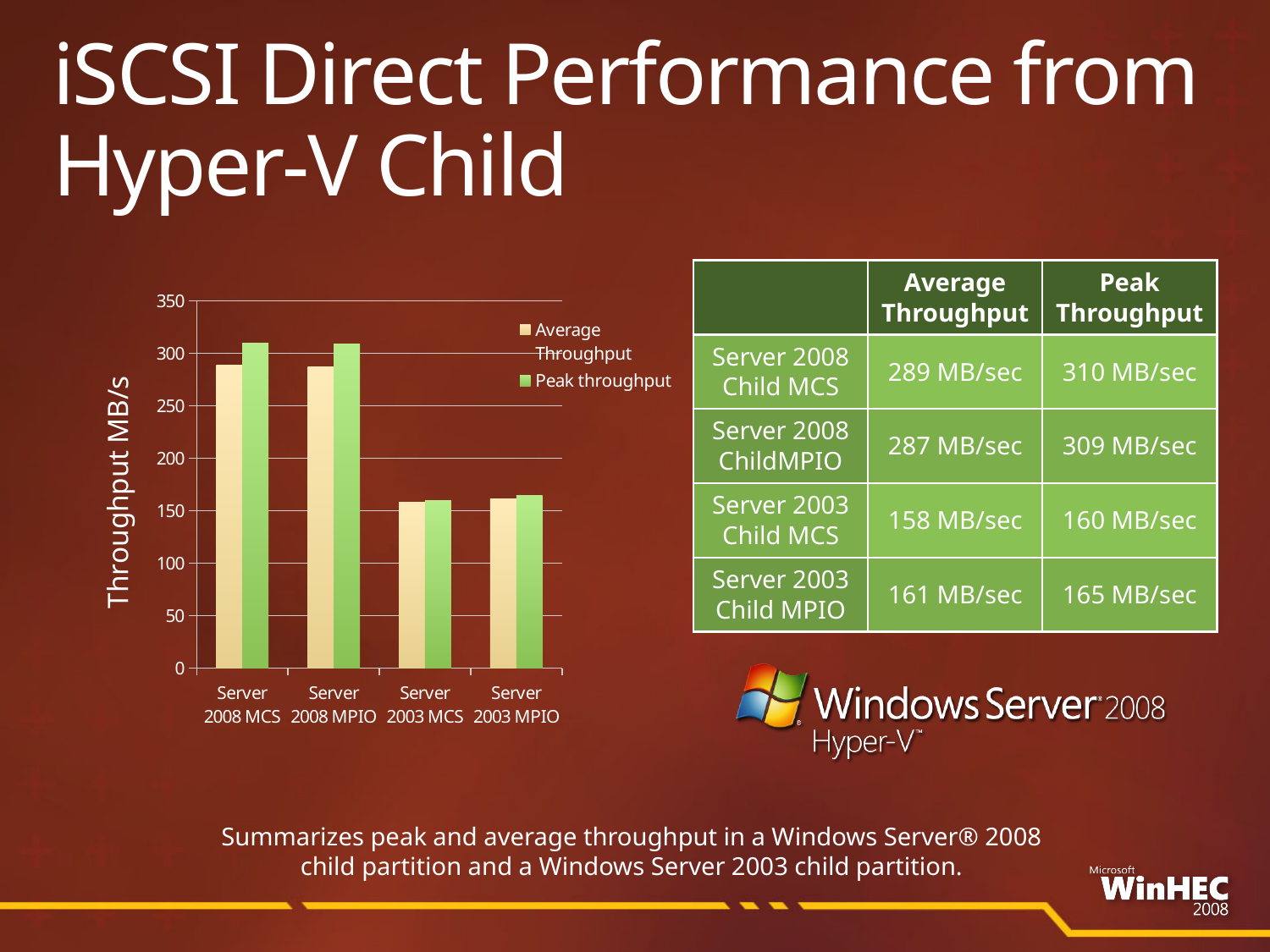
Which is larger, the average throughput for Server 2008 MCS or the average throughput for Server 2003 MCS? Server 2008 MCS What is the difference between the peak throughput and the average throughput for Server 2008 MPIO? 22 MB/sec Which category has the lowest average throughput? Server 2003 MCS How many series does the chart legend list? 2 What type of chart is shown on the slide? bar chart Is the average throughput bar for Server 2008 MPIO greater or less than 250? greater What is the label on the vertical axis of the chart? Throughput MB/s Is the peak throughput bar for Server 2003 MCS greater or less than 200? less Which category has the highest peak throughput? Server 2008 MCS What is the average throughput for Server 2008 MCS? 289 MB/sec What is the peak throughput for Server 2003 MPIO? 165 MB/sec How many categories are plotted on the x axis of the chart? 4